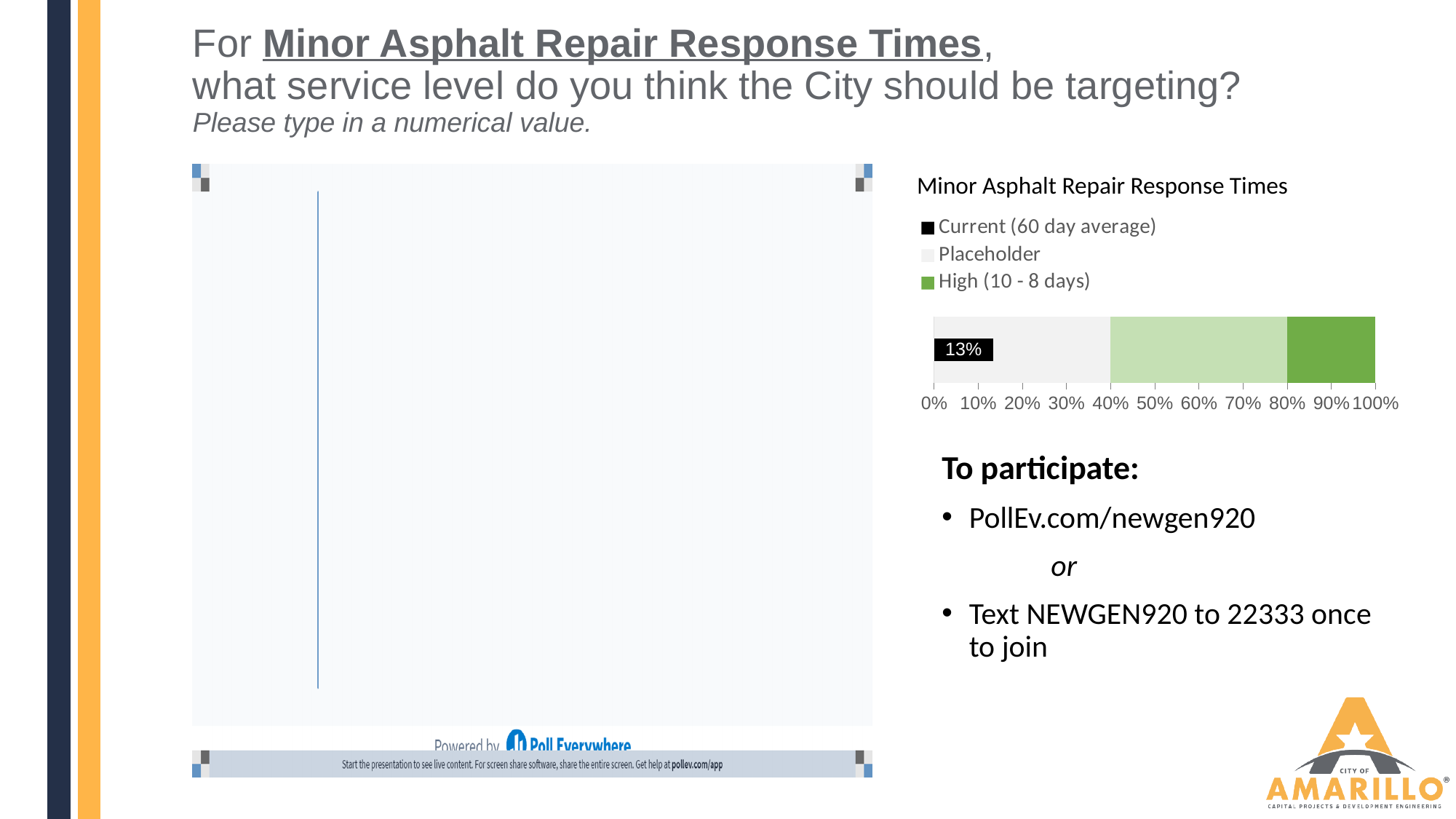
What is the highest tick label on the x axis of the "Minor Asphalt Repair Response Times" chart? 100% What kind of chart is the "Minor Asphalt Repair Response Times" chart? bar chart In the "Minor Asphalt Repair Response Times" chart, is the Current (60 day average) value greater or less than 10%? greater How many series does the legend of the "Minor Asphalt Repair Response Times" chart list? 3 What is the title of the chart on the right side of the slide? Minor Asphalt Repair Response Times In the "Minor Asphalt Repair Response Times" chart, what value is labelled on the Current (60 day average) bar? 13% In the "Minor Asphalt Repair Response Times" chart, is the Current (60 day average) value greater or less than 20%? less In the "Minor Asphalt Repair Response Times" chart, which legend entry is shown in black? Current (60 day average)